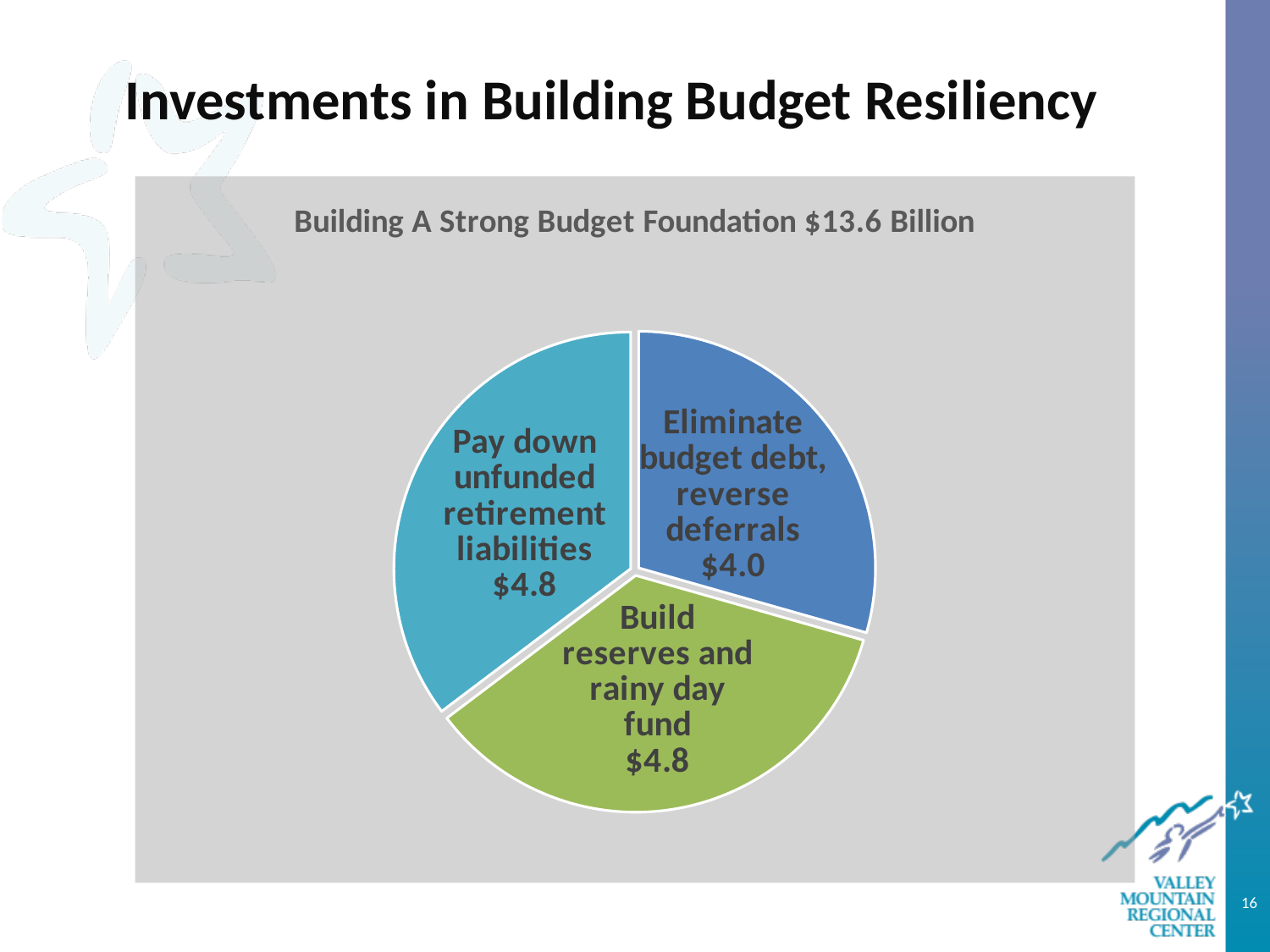
What is the difference between the 'Pay down unfunded retirement liabilities' value and the 'Eliminate budget debt, reverse deferrals' value? $0.8 What is the total of all the slices in the pie chart, as stated in the chart title? $13.6 Billion What colour is the 'Build reserves and rainy day fund' slice? green What is the value for the 'Eliminate budget debt, reverse deferrals' slice? $4.0 Which slice of the pie has the smallest value? Eliminate budget debt, reverse deferrals Which is larger: the value for 'Build reserves and rainy day fund' or the value for 'Eliminate budget debt, reverse deferrals'? Build reserves and rainy day fund What is the title of the pie chart? Building A Strong Budget Foundation $13.6 Billion What kind of chart is shown on the slide? pie chart What share of the pie does the 'Eliminate budget debt, reverse deferrals' slice represent? 29.4% What is the value for the 'Pay down unfunded retirement liabilities' slice? $4.8 How many slices does the pie chart have? 3 What is the value for the 'Build reserves and rainy day fund' slice? $4.8